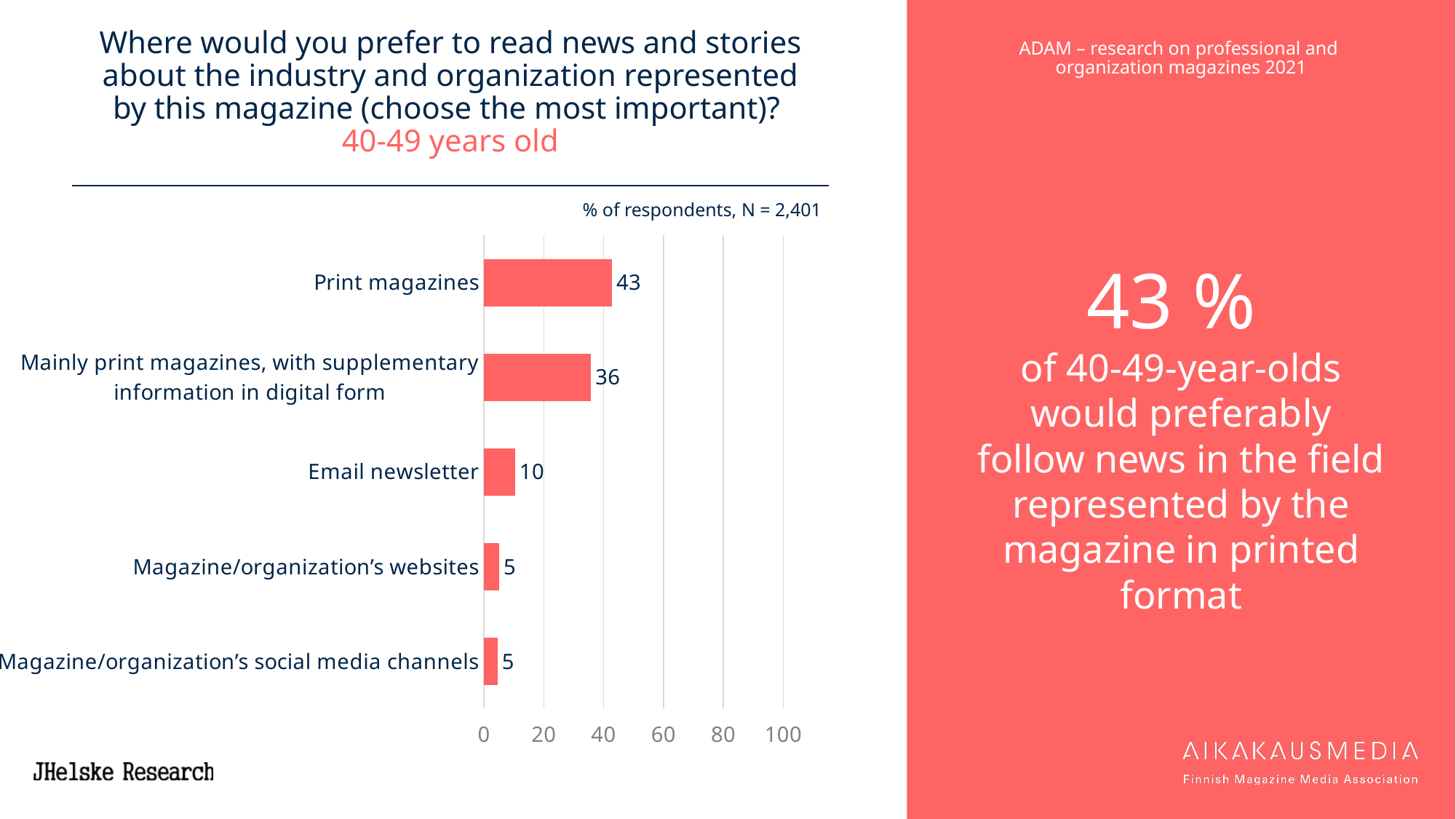
What is the value for Mainly print magazines, with supplementary information in digital form? 36 What age group does the chart cover, according to the subtitle? 40-49 years old How many categories are shown in the chart? 5 What is the value for Email newsletter? 10 What kind of chart is shown on the slide? Bar chart Which category has the highest value? Print magazines What is the difference between the values for Print magazines and Mainly print magazines, with supplementary information in digital form? 7 What is the value for Print magazines? 43 What is the difference between the values for Print magazines and Email newsletter? 33 Which is larger, the value for Email newsletter or the value for Magazine/organization's websites? Email newsletter Is the value for Print magazines greater or less than 40? greater What is the value for Magazine/organization's social media channels? 5